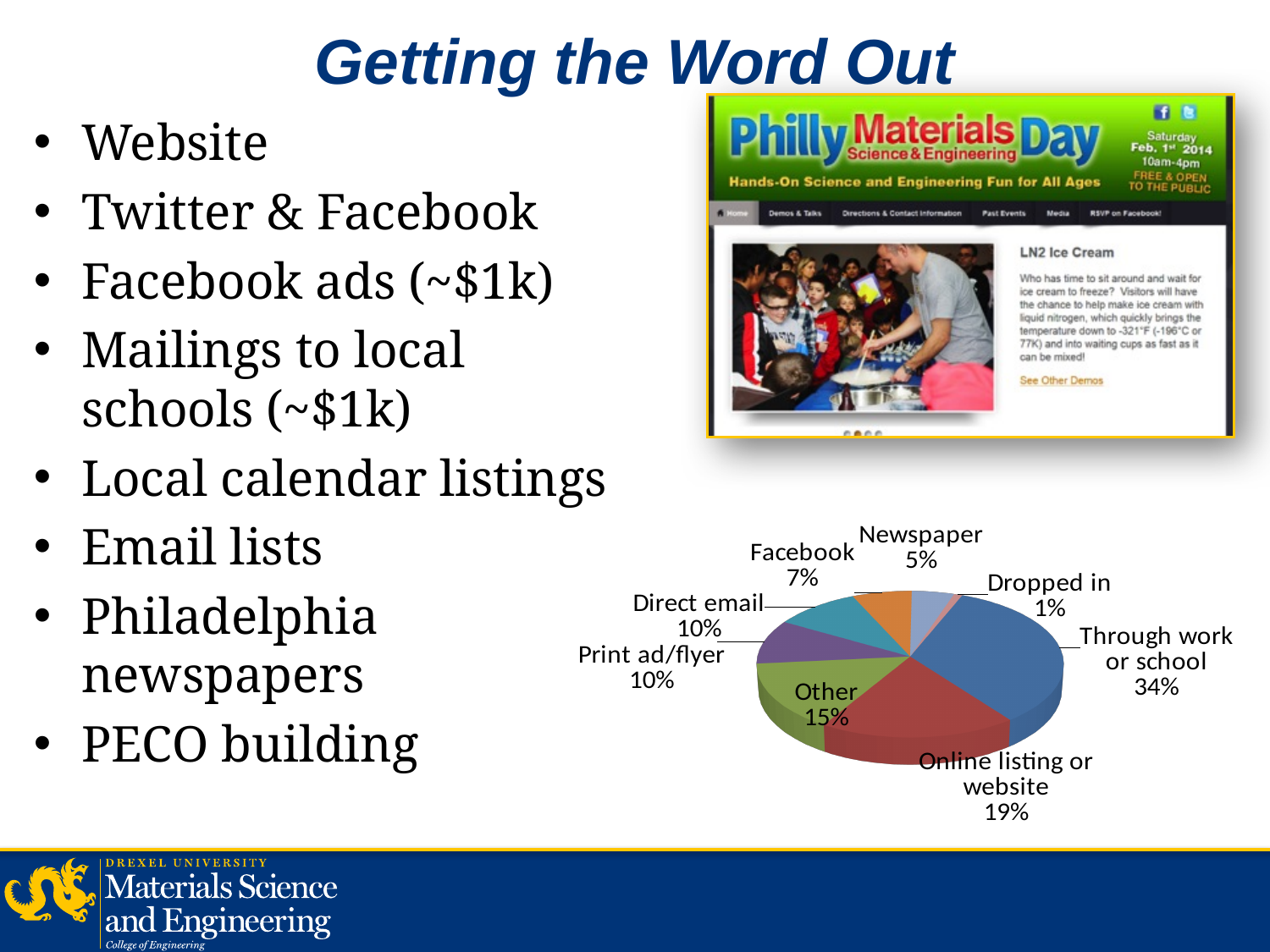
Which is larger, the share for "Other" or the share for "Direct email"? Other What percentage is shown for "Facebook"? 7% What percentage is shown for "Online listing or website"? 19% Which two categories each have a share of 10%? Direct email and Print ad/flyer What percentage is shown for "Newspaper"? 5% What kind of chart is shown on the slide? pie chart What percentage is shown for "Other"? 15% What share of the pie is "Through work or school"? 34% What is the difference in percentage points between "Through work or school" and "Online listing or website"? 15 Which category has the smallest slice of the pie? Dropped in How many slices does the pie chart have? 8 Which category has the largest slice of the pie? Through work or school